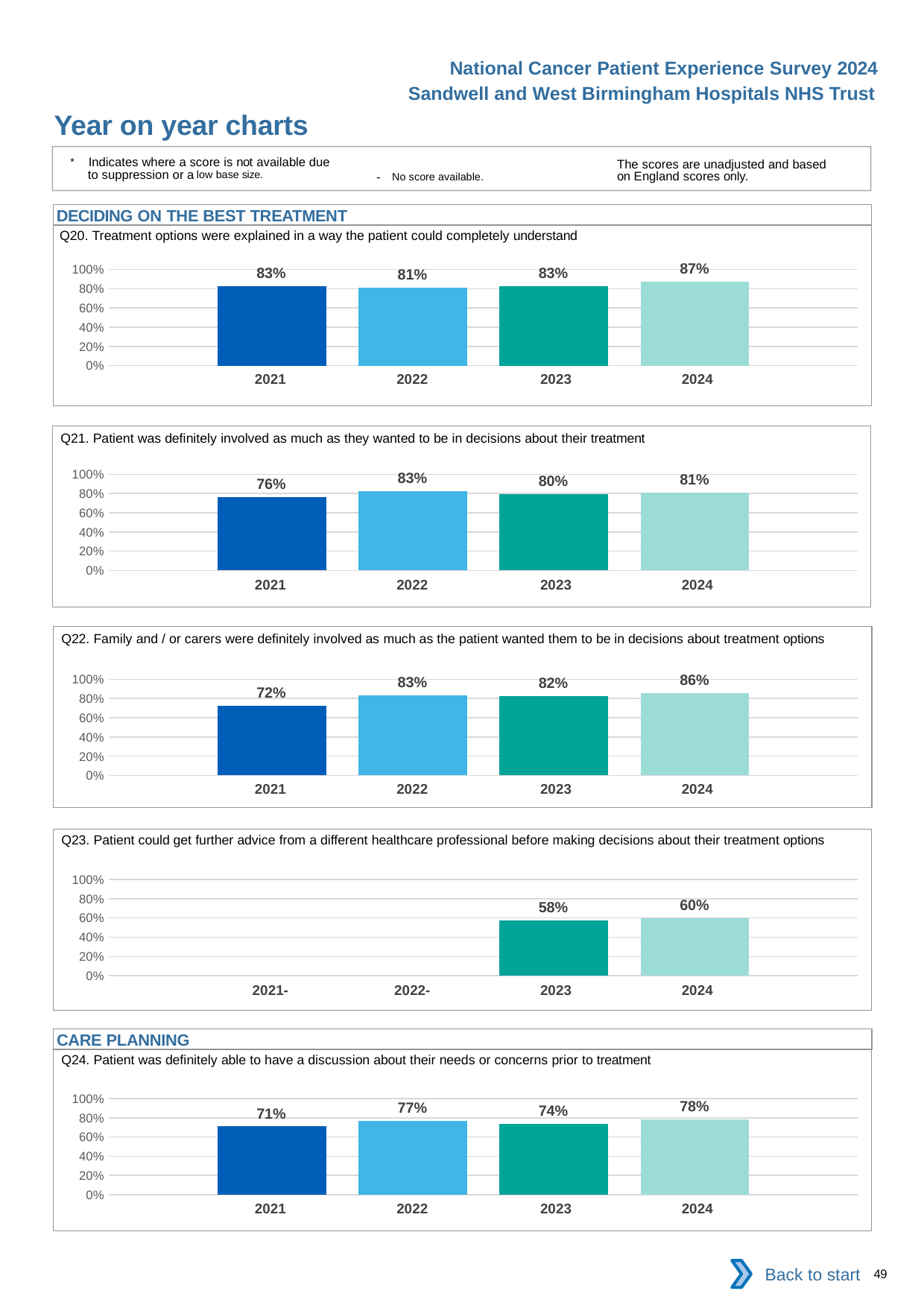
In the Q21 chart, which year has the lowest value? 2021 What kind of chart is the Q22 chart? bar chart In the Q24 chart, what is the difference between the 2022 and 2021 values? 6% In the Q22 chart, is the value for 2021 greater or less than 80%? less In the Q23 chart, what is the value for 2023? 58% In the Q24 chart, which year has the highest value? 2024 In the Q20 chart, what is the value for 2024? 87% In the Q23 chart, how many years have a score shown? 2 Which section heading appears above the Q24 chart? CARE PLANNING In the Q22 chart, what is the difference between the 2024 and 2021 values? 14% In the Q20 chart, what is the value for 2022? 81% In the Q21 chart, which is larger, the value for 2022 or the value for 2023? 2022